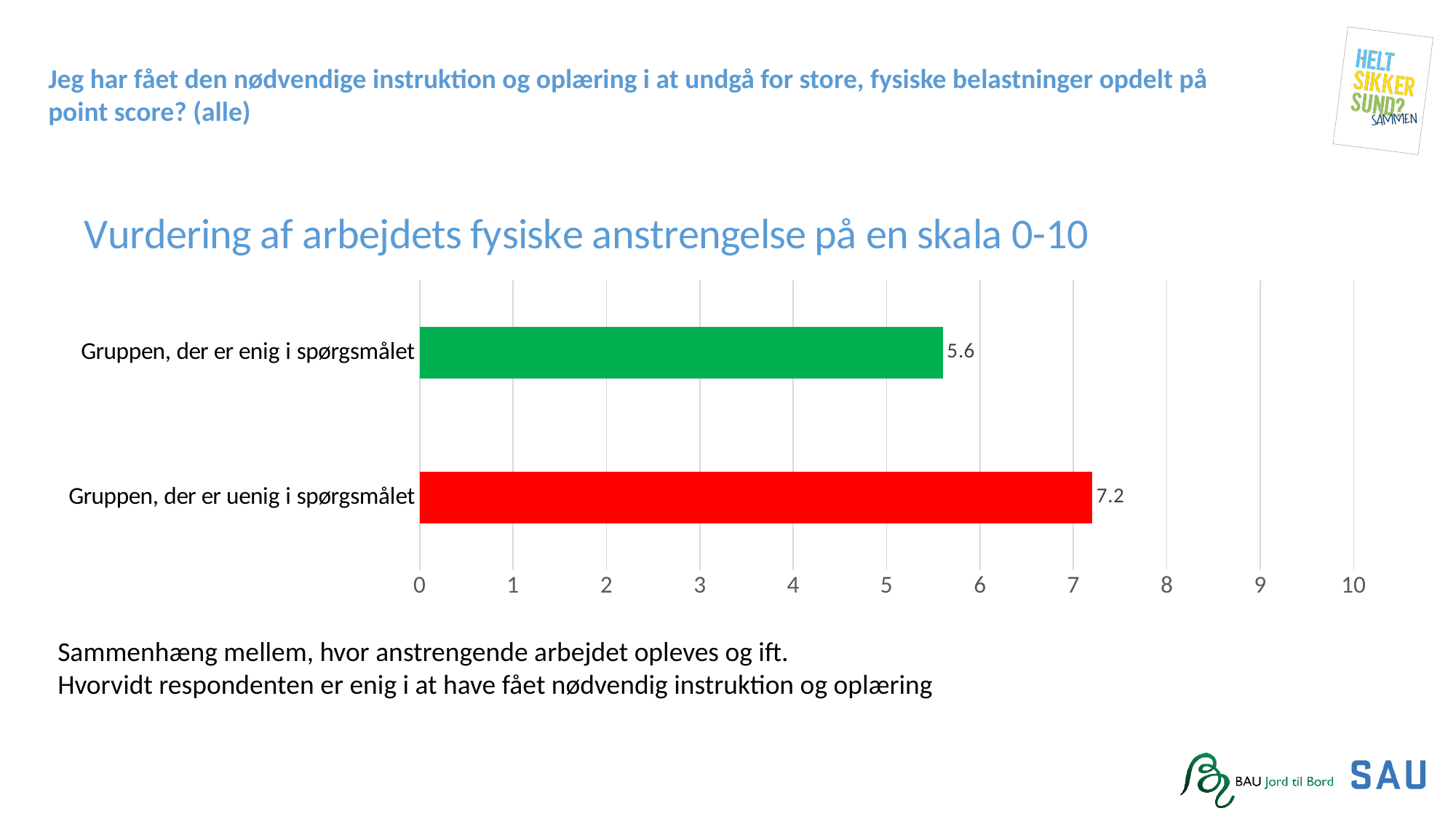
What is the value for "Gruppen, der er uenig i spørgsmålet"? 7.2 What kind of chart is shown on the slide? bar chart Is the value for "Gruppen, der er enig i spørgsmålet" greater or less than 6? less Which group has the lowest value? Gruppen, der er enig i spørgsmålet Which group has the highest value? Gruppen, der er uenig i spørgsmålet What colour is the bar for "Gruppen, der er uenig i spørgsmålet"? red What is the title of the chart? Vurdering af arbejdets fysiske anstrengelse på en skala 0-10 What is the value for "Gruppen, der er enig i spørgsmålet"? 5.6 Is the value for "Gruppen, der er uenig i spørgsmålet" greater or less than 7? greater Which is larger: the value for "Gruppen, der er enig i spørgsmålet" or "Gruppen, der er uenig i spørgsmålet"? Gruppen, der er uenig i spørgsmålet How many categories are shown in the chart? 2 What is the difference between the value for "Gruppen, der er uenig i spørgsmålet" and "Gruppen, der er enig i spørgsmålet"? 1.6